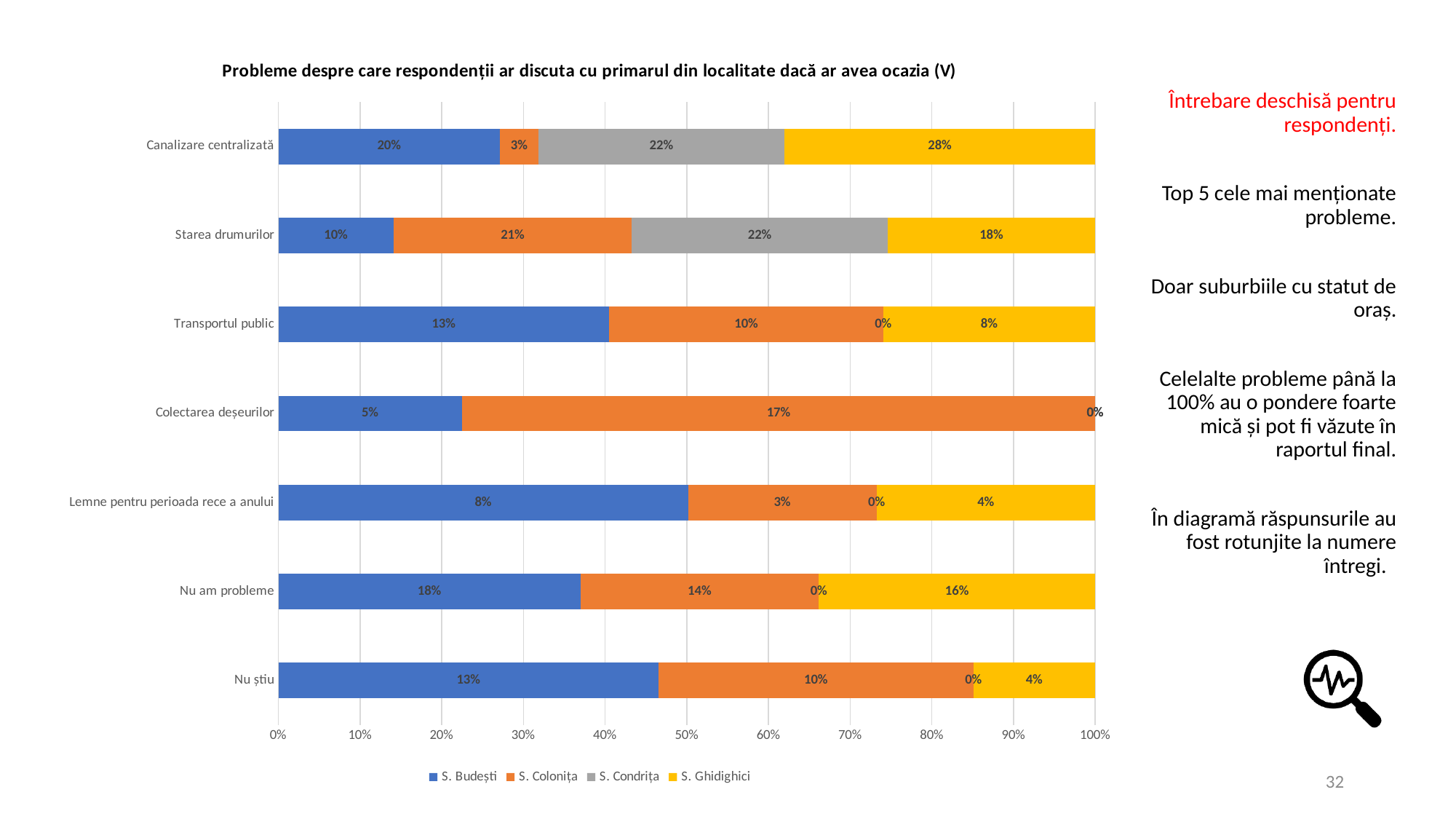
How many series does the legend list? 4 What is the value for S. Budești in the Nu am probleme bar? 18% What kind of chart is shown on the slide? Stacked bar chart What is the value for S. Colonița in the Starea drumurilor bar? 21% What is the title of the chart? Probleme despre care respondenții ar discuta cu primarul din localitate dacă ar avea ocazia (V) How many categories are shown on the chart? 7 In the Canalizare centralizată bar, what is the difference between the S. Ghidighici value and the S. Budești value? 8% For the S. Budești series, which category has the highest value? Canalizare centralizată In the Starea drumurilor bar, which is larger: the S. Colonița value or the S. Ghidighici value? S. Colonița What is the value for S. Condrița in the Starea drumurilor bar? 22% What is the value for S. Ghidighici in the Canalizare centralizată bar? 28% For the S. Budești series, which category has the lowest value? Colectarea deșeurilor